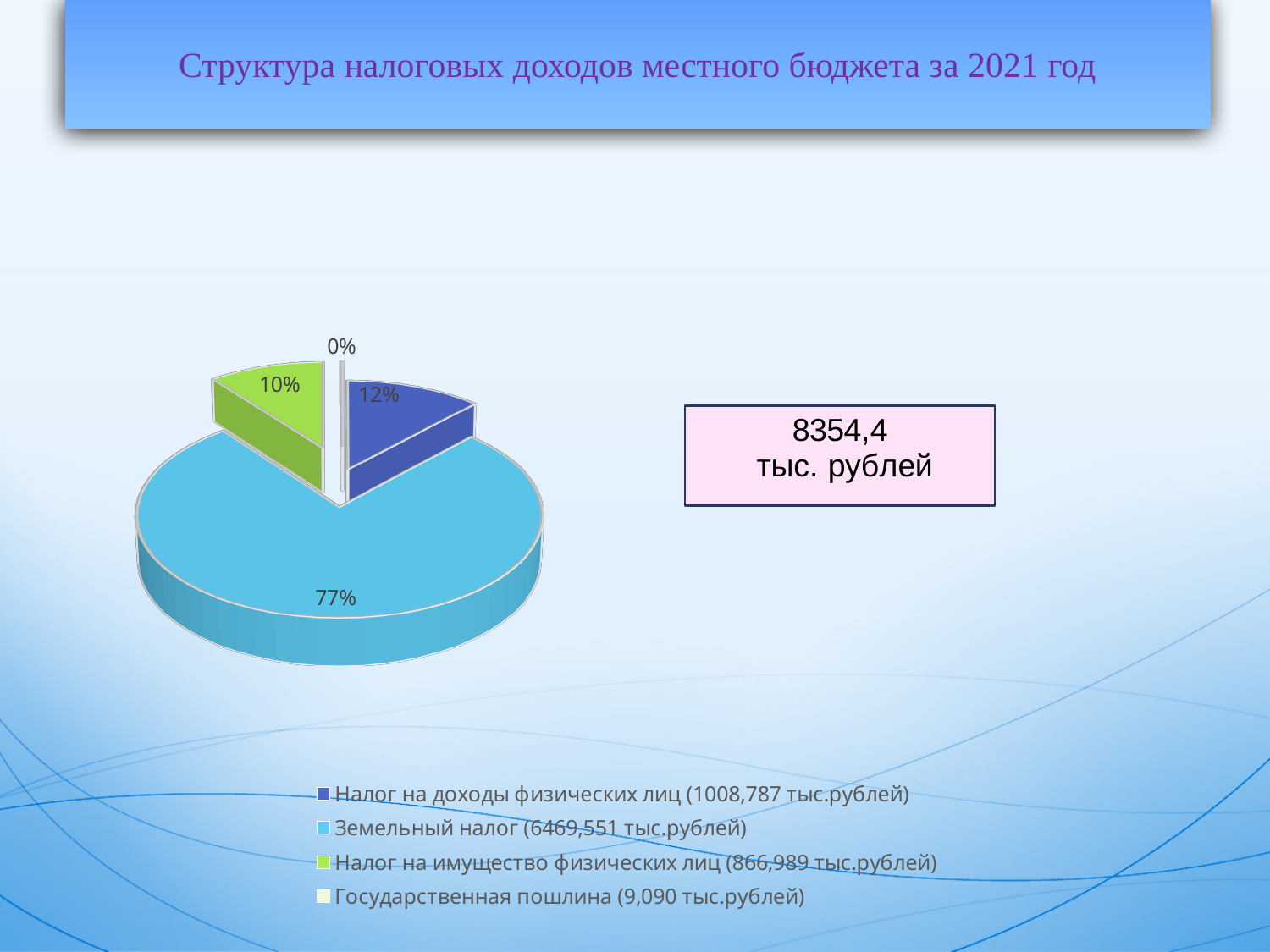
What is the title of the slide containing the pie chart? Структура налоговых доходов местного бюджета за 2021 год According to the legend, what amount in тыс.рублей is given for Земельный налог? 6469,551 тыс.рублей What share of the pie does Налог на имущество физических лиц take? 10% What share of the pie does Налог на доходы физических лиц take? 12% How many categories does the pie chart show? 4 What share of the pie does Земельный налог take? 77% Which category has the largest slice of the pie? Земельный налог Which is larger: the share of Налог на доходы физических лиц or the share of Налог на имущество физических лиц? Налог на доходы физических лиц What kind of chart is shown on the slide? pie chart By how many percentage points does the share of Земельный налог exceed the share of Налог на доходы физических лиц? 65 Which category has the smallest slice of the pie? Государственная пошлина